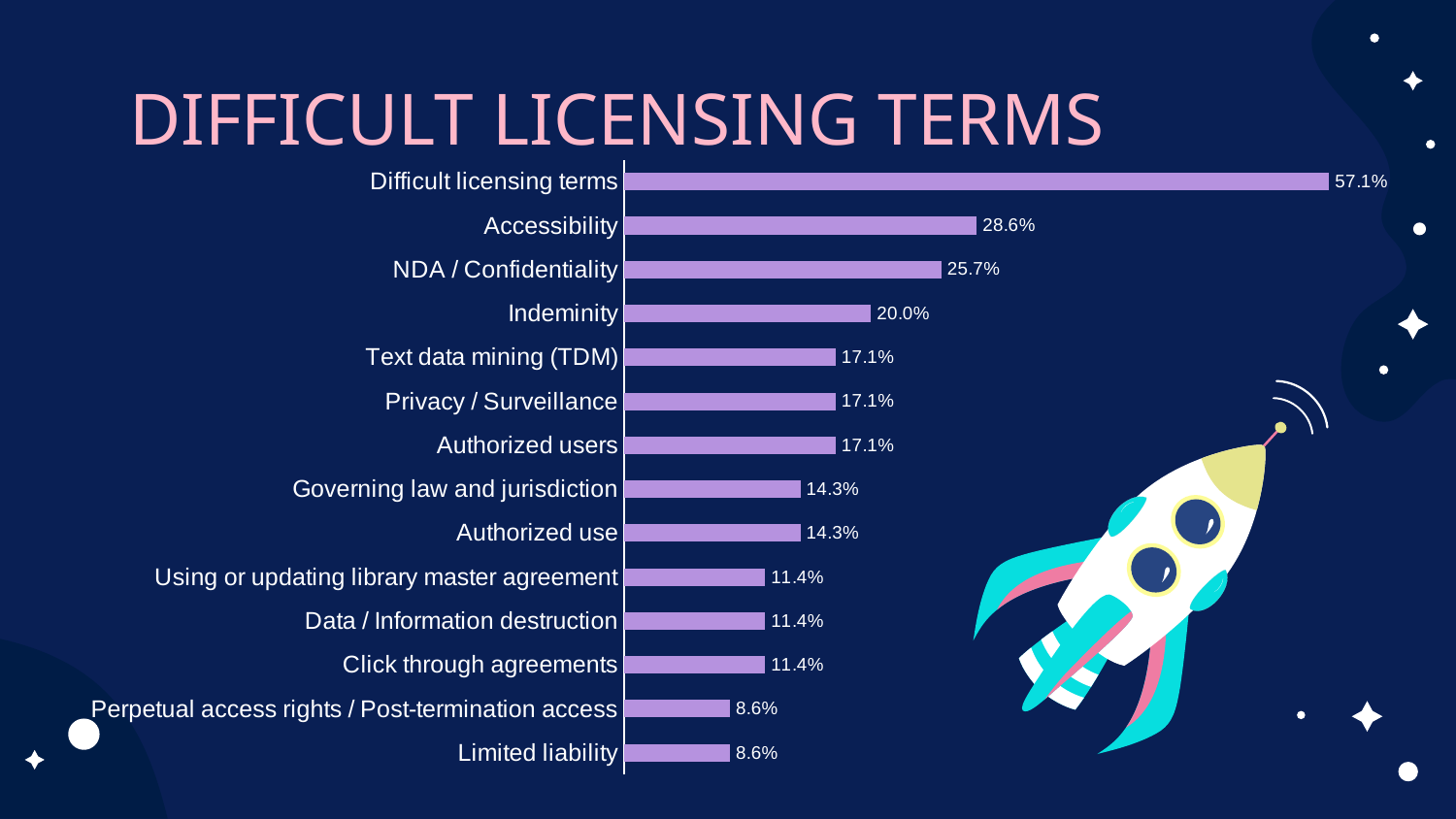
Which is larger, the value for NDA / Confidentiality or the value for Indeminity? NDA / Confidentiality What kind of chart is shown on the slide? Bar chart What is the value for NDA / Confidentiality? 25.7% What is the value for Limited liability? 8.6% Which is larger, the value for Authorized use or the value for Click through agreements? Authorized use What is the difference between the values for Difficult licensing terms and Accessibility? 28.5% What is the title of the slide? DIFFICULT LICENSING TERMS Which category has the highest value? Difficult licensing terms What is the value for Accessibility? 28.6% How many categories are shown in the chart? 14 What is the difference between the values for Indeminity and Authorized users? 2.9% What is the value for Governing law and jurisdiction? 14.3%